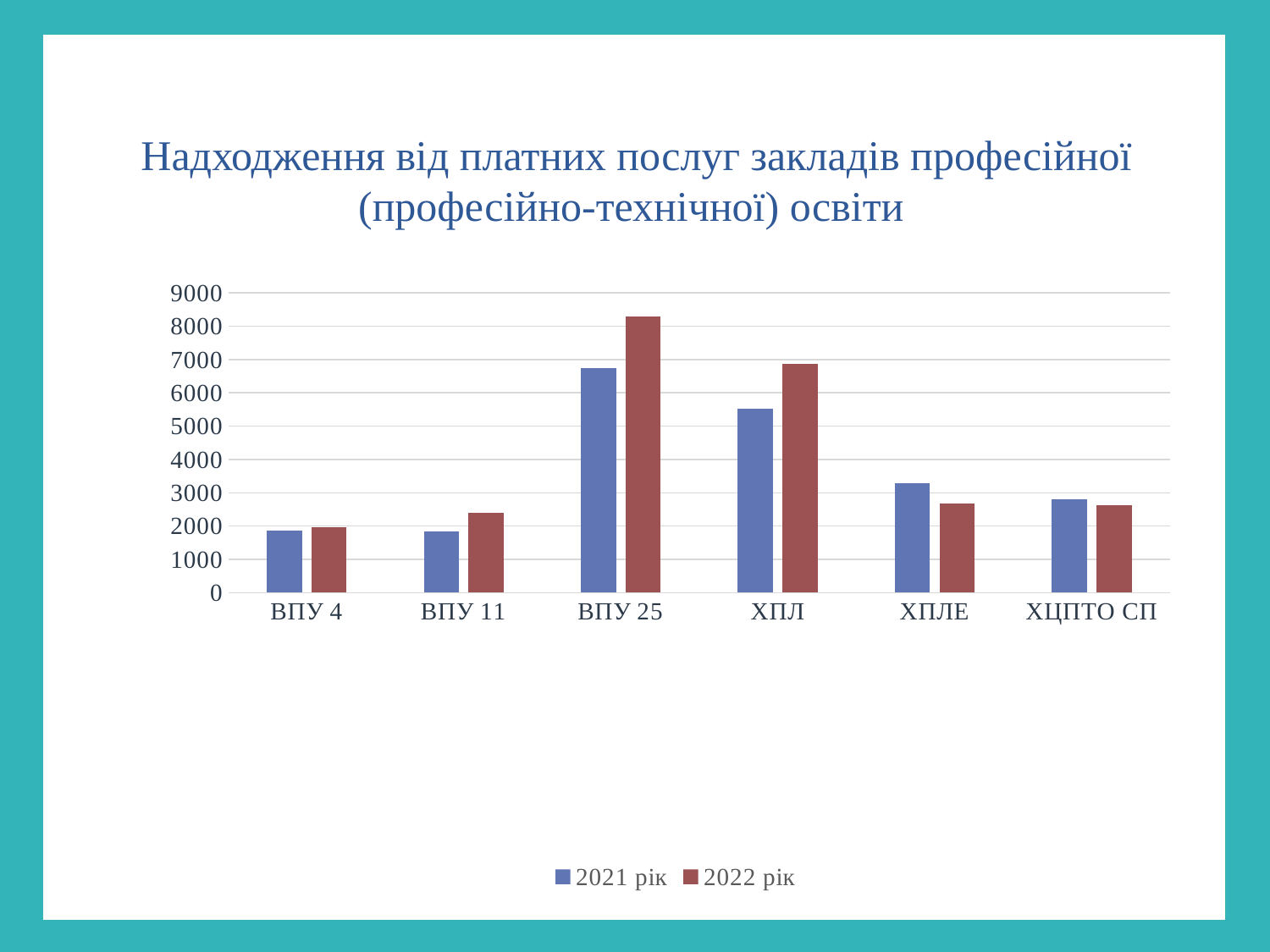
Is the value for ХПЛ in 2021 рік greater or less than 5000? greater Is the value for ВПУ 25 in 2022 рік greater or less than 8000? greater How many series does the legend list? 2 For ХПЛЕ, which year has the larger value, 2021 рік or 2022 рік? 2021 рік For ВПУ 11, which year has the larger value, 2021 рік or 2022 рік? 2022 рік Which institution has the lowest value for 2022 рік? ВПУ 4 Which institution has the highest value for 2022 рік? ВПУ 25 What kind of chart is shown on the slide? bar chart How many institutions (categories) are shown on the x axis? 6 Which institution has the highest value for 2021 рік? ВПУ 25